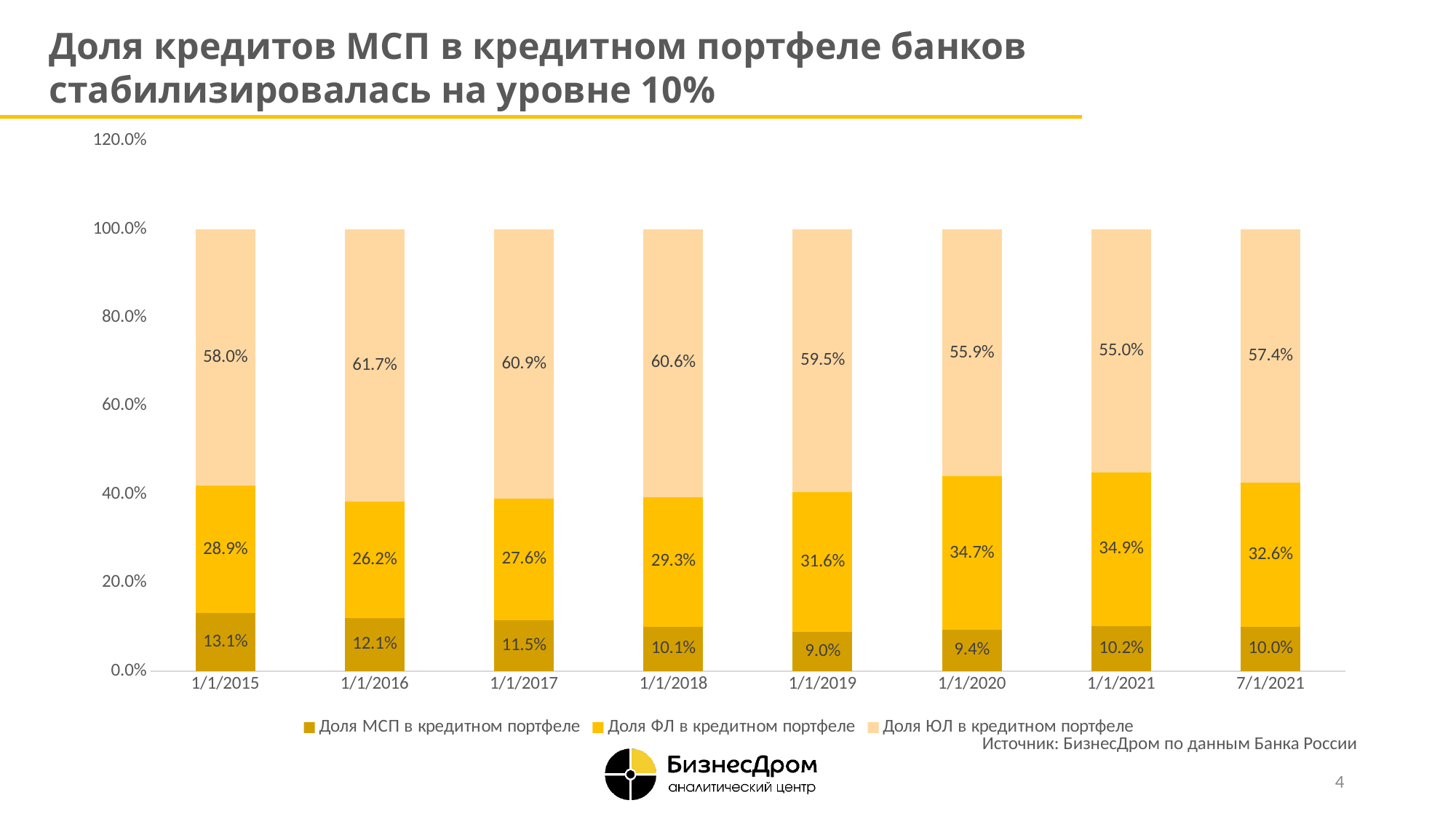
What kind of chart is shown on the slide? Stacked bar chart On which date is Доля ФЛ в кредитном портфеле the highest? 1/1/2021 How many series does the legend list? 3 What is the value of Доля МСП в кредитном портфеле for 1/1/2015? 13.1% Does Доля МСП в кредитном портфеле rise or fall from 1/1/2015 to 1/1/2019? Fall What is the difference between Доля ФЛ в кредитном портфеле on 1/1/2021 and on 1/1/2015? 6.0 percentage points On which date is Доля МСП в кредитном портфеле the lowest? 1/1/2019 What is the value of Доля ЮЛ в кредитном портфеле for 1/1/2016? 61.7% On which date is Доля МСП в кредитном портфеле the highest? 1/1/2015 What is the value of Доля ФЛ в кредитном портфеле for 7/1/2021? 32.6% How many dates are shown on the x axis? 8 Which is larger: Доля МСП в кредитном портфеле on 1/1/2020 or on 1/1/2021? 1/1/2021